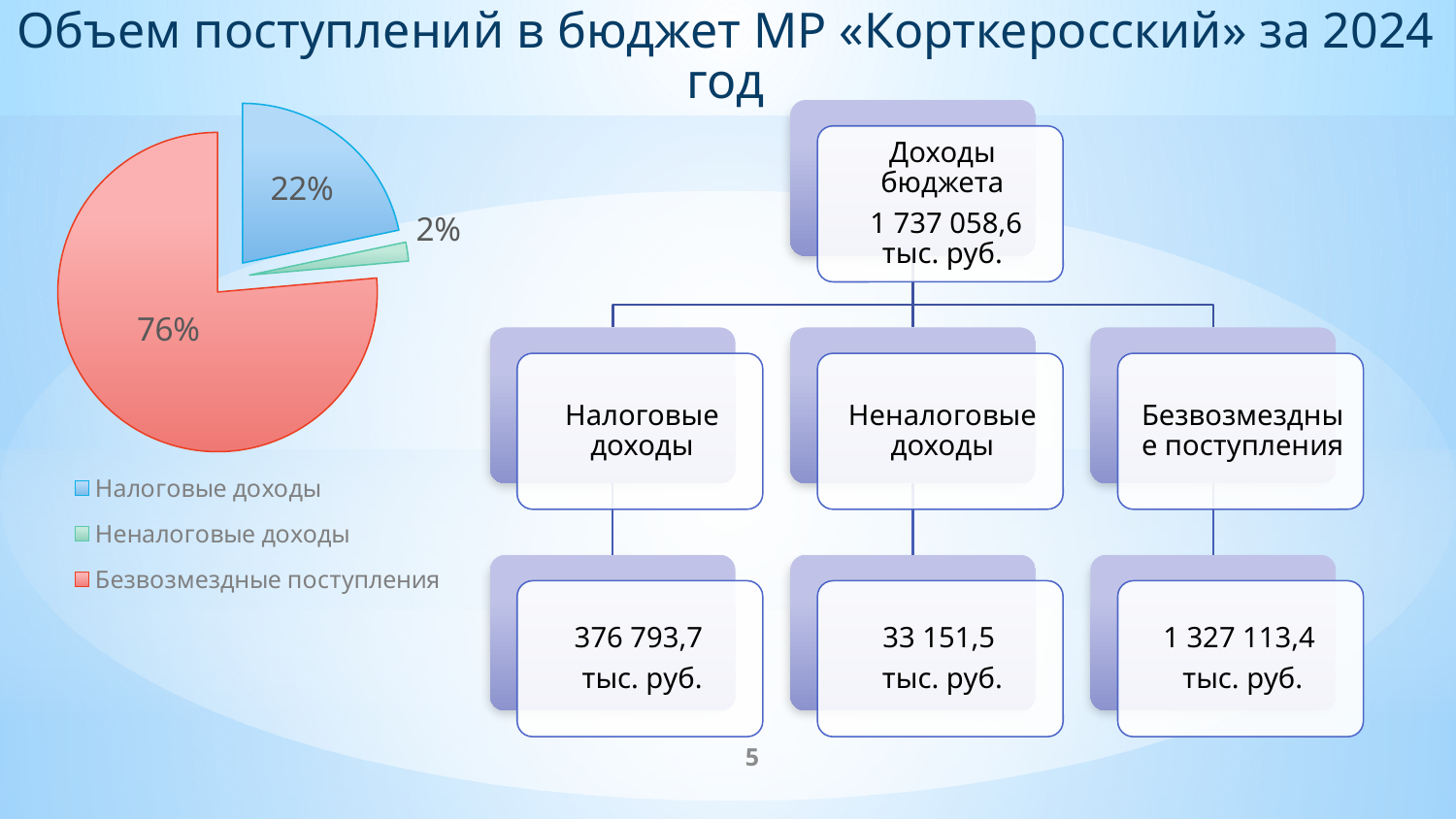
What type of chart is shown on the left of the slide? Pie chart How many entries does the pie chart legend list? 3 Which category has the largest slice in the pie chart? Безвозмездные поступления What colour is the Налоговые доходы slice in the pie chart? Blue Which category has the smallest slice in the pie chart? Неналоговые доходы What share of the pie chart is labelled Безвозмездные поступления? 76% What share of the pie chart is labelled Неналоговые доходы? 2% What share of the pie chart is labelled Налоговые доходы? 22% Which slice is larger in the pie chart: Налоговые доходы or Неналоговые доходы? Налоговые доходы How many slices does the pie chart have? 3 By how many percentage points does the Безвозмездные поступления slice exceed the Налоговые доходы slice? 54 percentage points What colour is the Безвозмездные поступления slice in the pie chart? Red